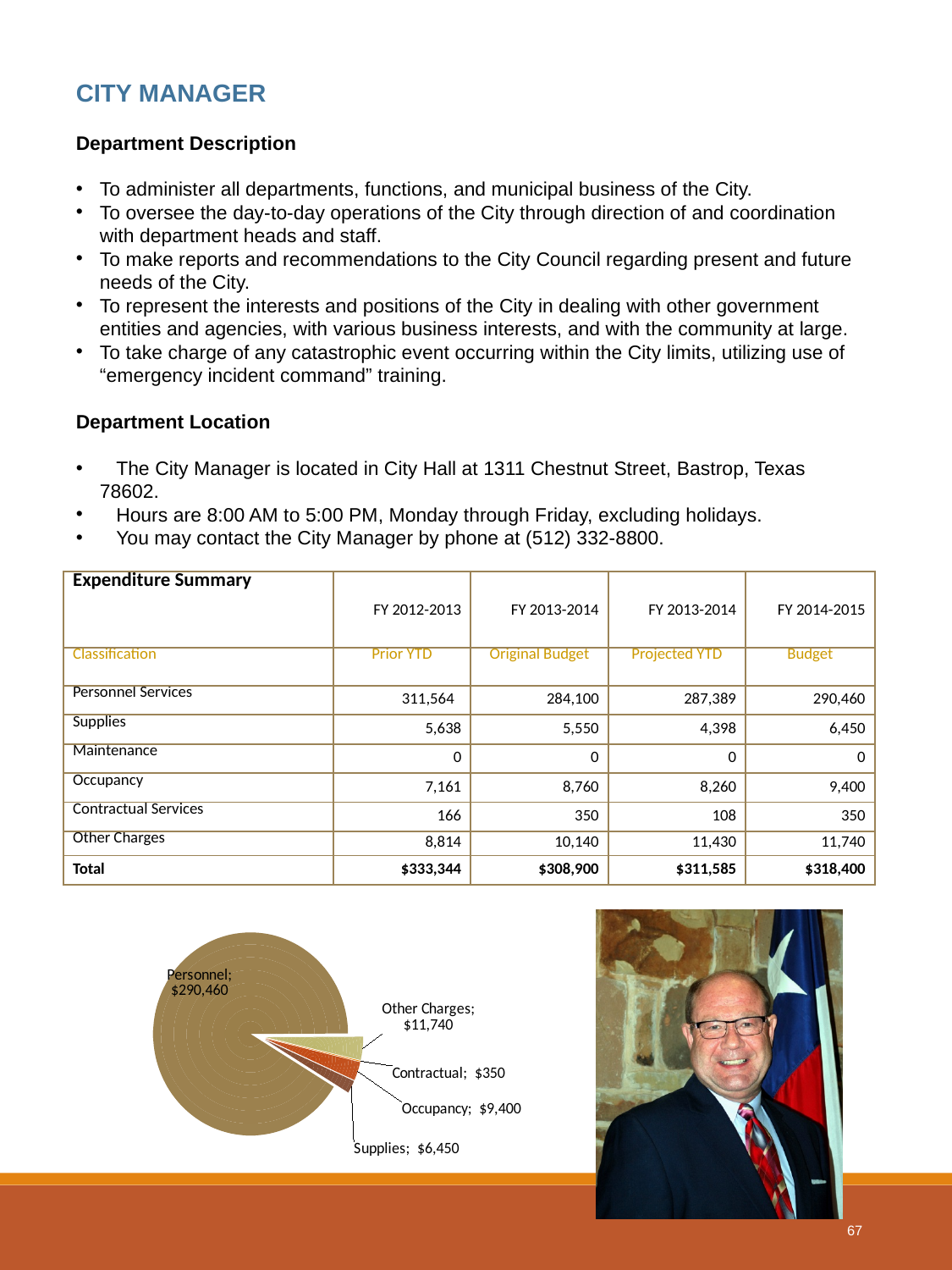
In the pie chart, what is the difference between the Other Charges value and the Occupancy value? $2,340 Which slice of the pie chart is the smallest? Contractual In the pie chart, what is the value shown for Supplies? $6,450 In the pie chart, what is the value shown for Contractual? $350 In the pie chart, are the slice values shown as data labels next to the slices or in a separate legend? data labels How many slices does the pie chart have? 5 In the pie chart, what is the value shown for Other Charges? $11,740 In the pie chart, what is the value shown for Occupancy? $9,400 What kind of chart is shown at the bottom left of the slide? pie chart Which slice of the pie chart is the largest? Personnel In the pie chart, which is larger: Occupancy or Supplies? Occupancy In the pie chart, what is the value shown for Personnel? $290,460